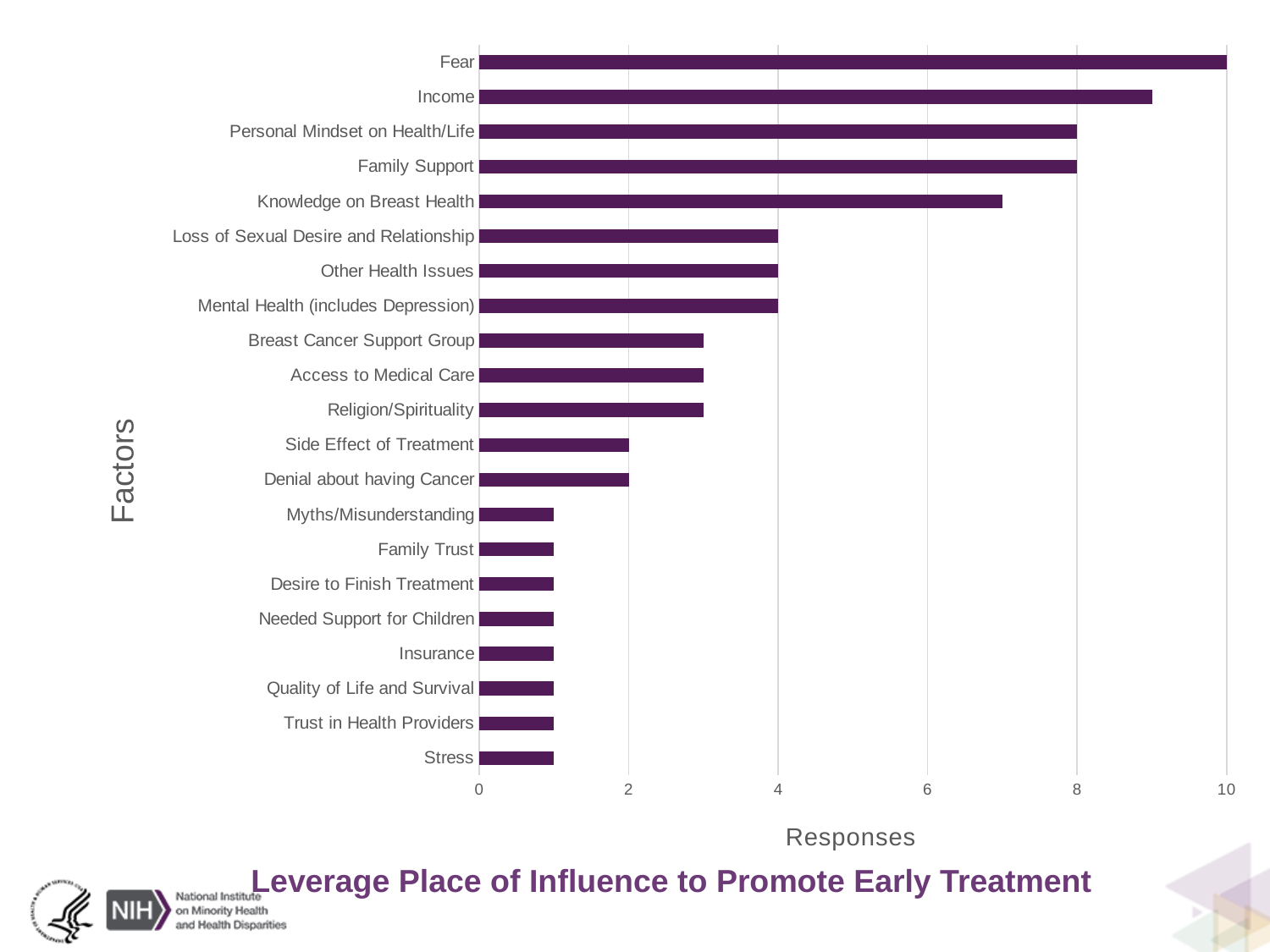
Is the value for Income greater or less than 8? greater How many responses are shown for Mental Health (includes Depression)? 4 How many responses are shown for Fear? 10 Which has more responses, Income or Knowledge on Breast Health? Income How many factors are listed on the chart? 21 What type of chart is shown on the slide? bar chart Is the value for Access to Medical Care greater or less than 4? less What is the difference in responses between Fear and Personal Mindset on Health/Life? 2 How many responses are shown for Family Support? 8 What is the label of the horizontal axis? Responses How many responses are shown for Side Effect of Treatment? 2 Which factor has the highest number of responses? Fear